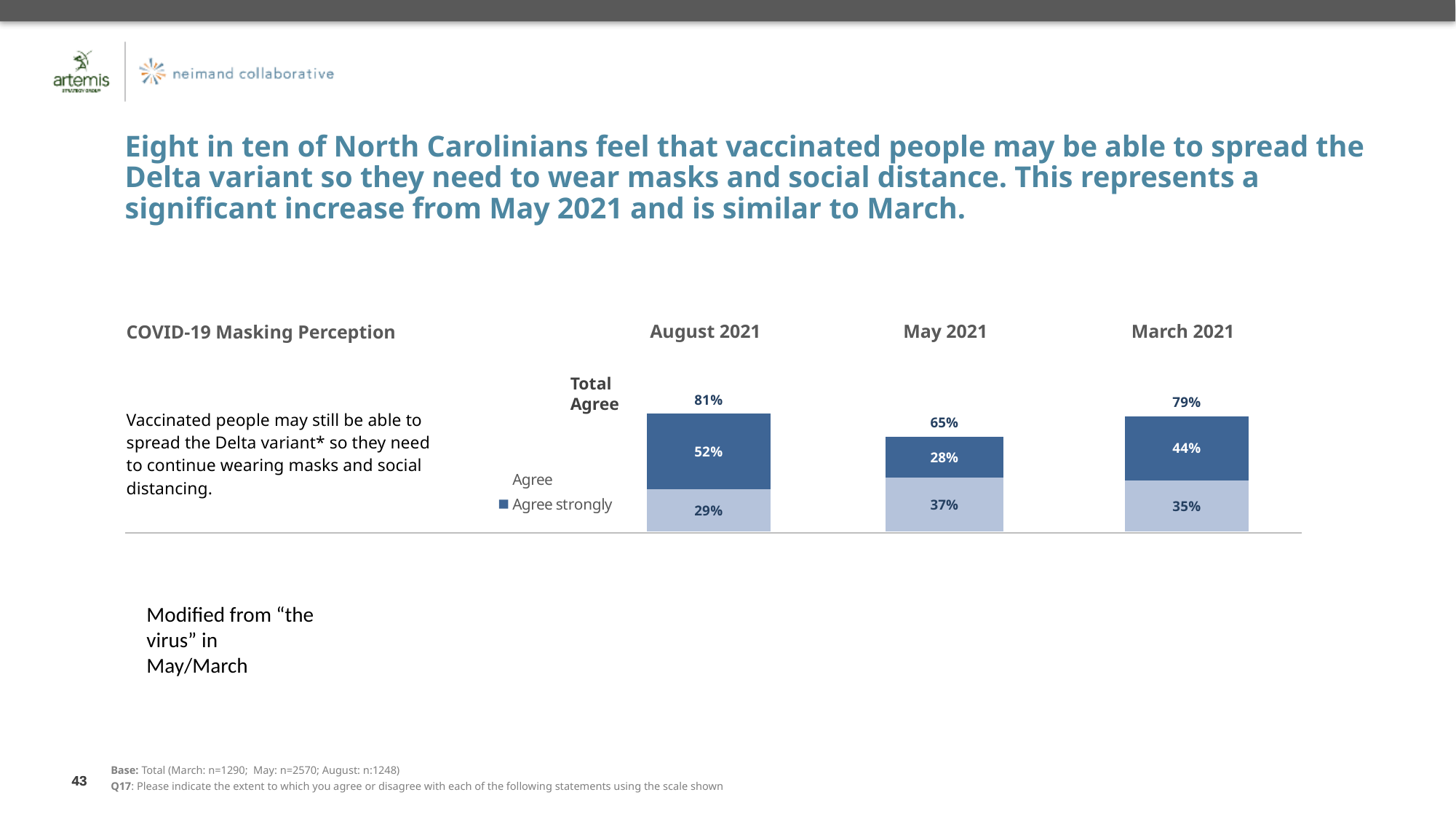
What is the Total Agree value for August 2021? 81% How many series does the legend list? 2 What is the Agree value for May 2021? 37% Which legend entry is shown in the darker blue colour? Agree strongly Which survey wave has the lowest Total Agree value? May 2021 What is the Agree strongly value for March 2021? 44% What is the Total Agree value for May 2021? 65% How many survey waves are shown in the chart? 3 Which survey wave has the highest Agree strongly value? August 2021 What kind of chart is shown on the slide? Stacked bar chart Which is larger, the Agree strongly value for August 2021 or for March 2021? August 2021 What is the difference between the Total Agree values for August 2021 and May 2021? 16 percentage points